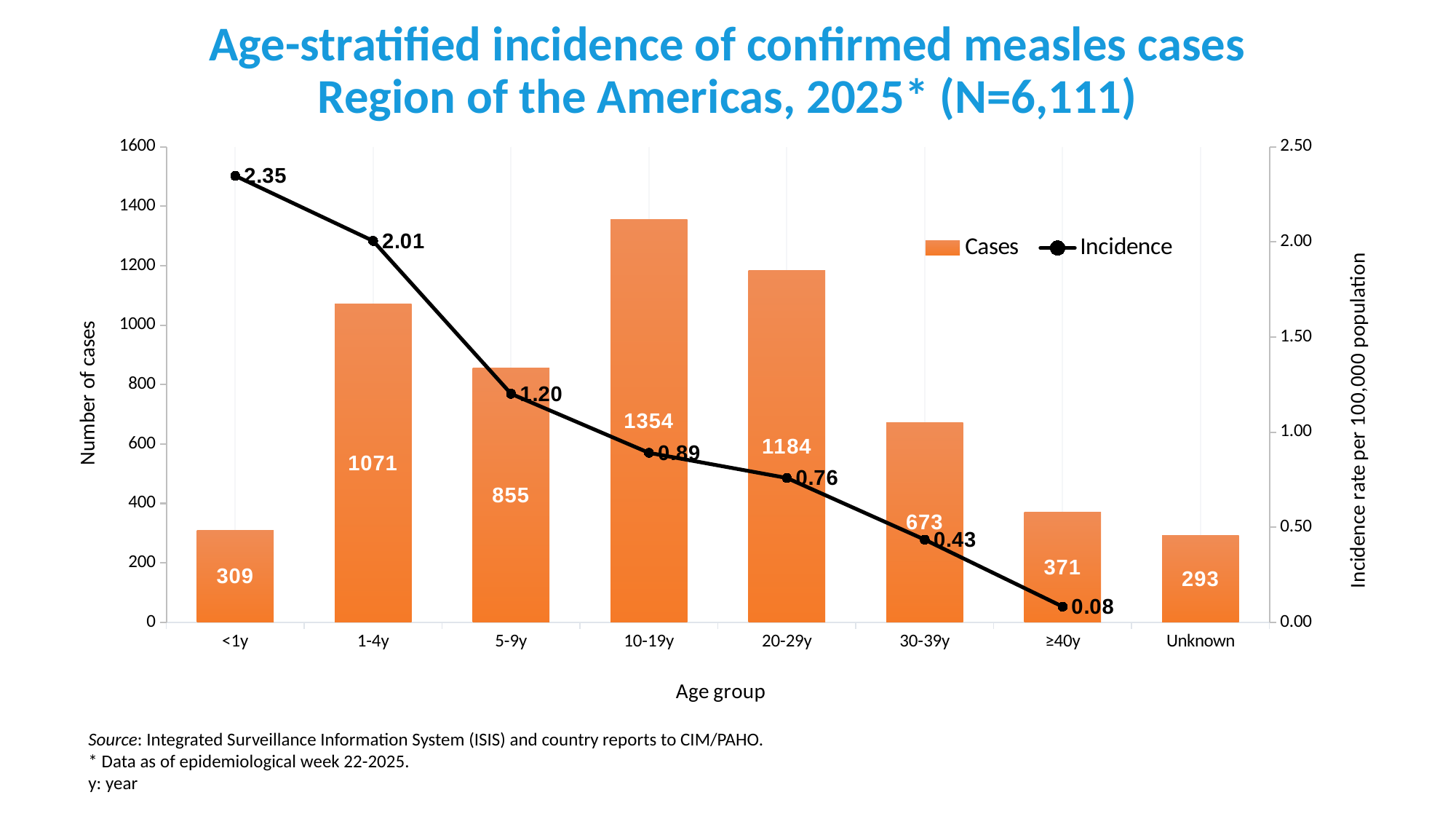
Does the incidence rate rise or fall from the <1y group to the ≥40y group? fall What is the label of the right-hand vertical axis? Incidence rate per 100,000 population How many confirmed measles cases are shown for the 10-19y age group? 1354 How many series does the legend list? 2 How many cases are reported for the Unknown age group? 293 How many age group categories are shown on the x axis? 8 Which has more cases, the 20-29y age group or the 30-39y age group? 20-29y Is the number of cases for the ≥40y age group greater or less than 400? less What is the incidence rate per 100,000 population for the <1y age group? 2.35 What is the difference in number of cases between the 1-4y and 5-9y age groups? 216 Which age group has the highest number of cases? 10-19y Which age group has the lowest incidence rate? ≥40y